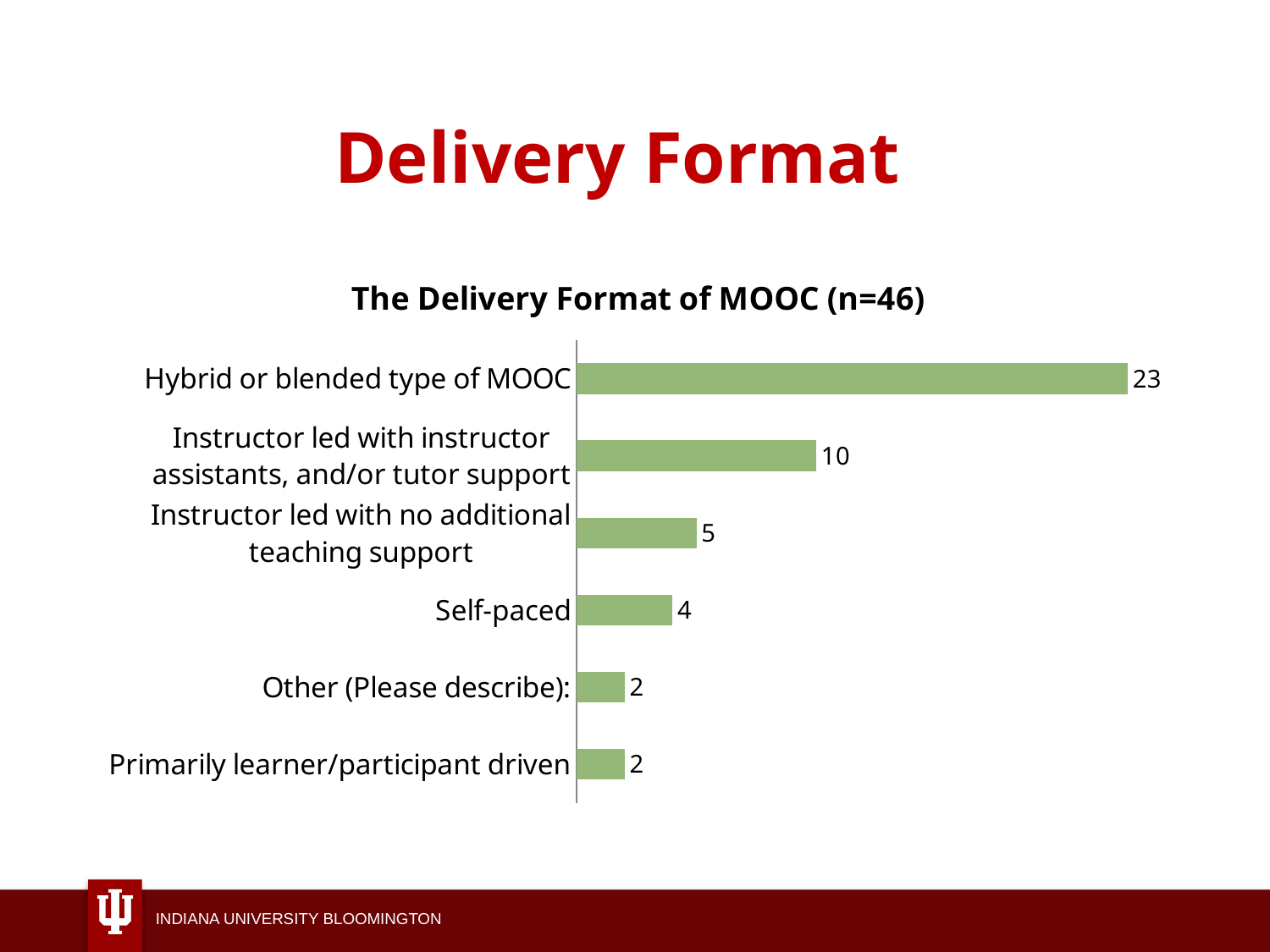
What is the value for Self-paced? 4 What is the difference between the values for Self-paced and Other (Please describe):? 2 What is the value for Instructor led with no additional teaching support? 5 What is the value for Hybrid or blended type of MOOC? 23 How many categories are shown in the chart? 6 What is the title of the chart? The Delivery Format of MOOC (n=46) What is the value for Instructor led with instructor assistants, and/or tutor support? 10 What kind of chart is shown on the slide? Bar chart What is the difference between the values for Hybrid or blended type of MOOC and Instructor led with instructor assistants, and/or tutor support? 13 Which is larger, the value for Self-paced or the value for Instructor led with no additional teaching support? Instructor led with no additional teaching support Which delivery format has the highest value? Hybrid or blended type of MOOC What is the value for Primarily learner/participant driven? 2